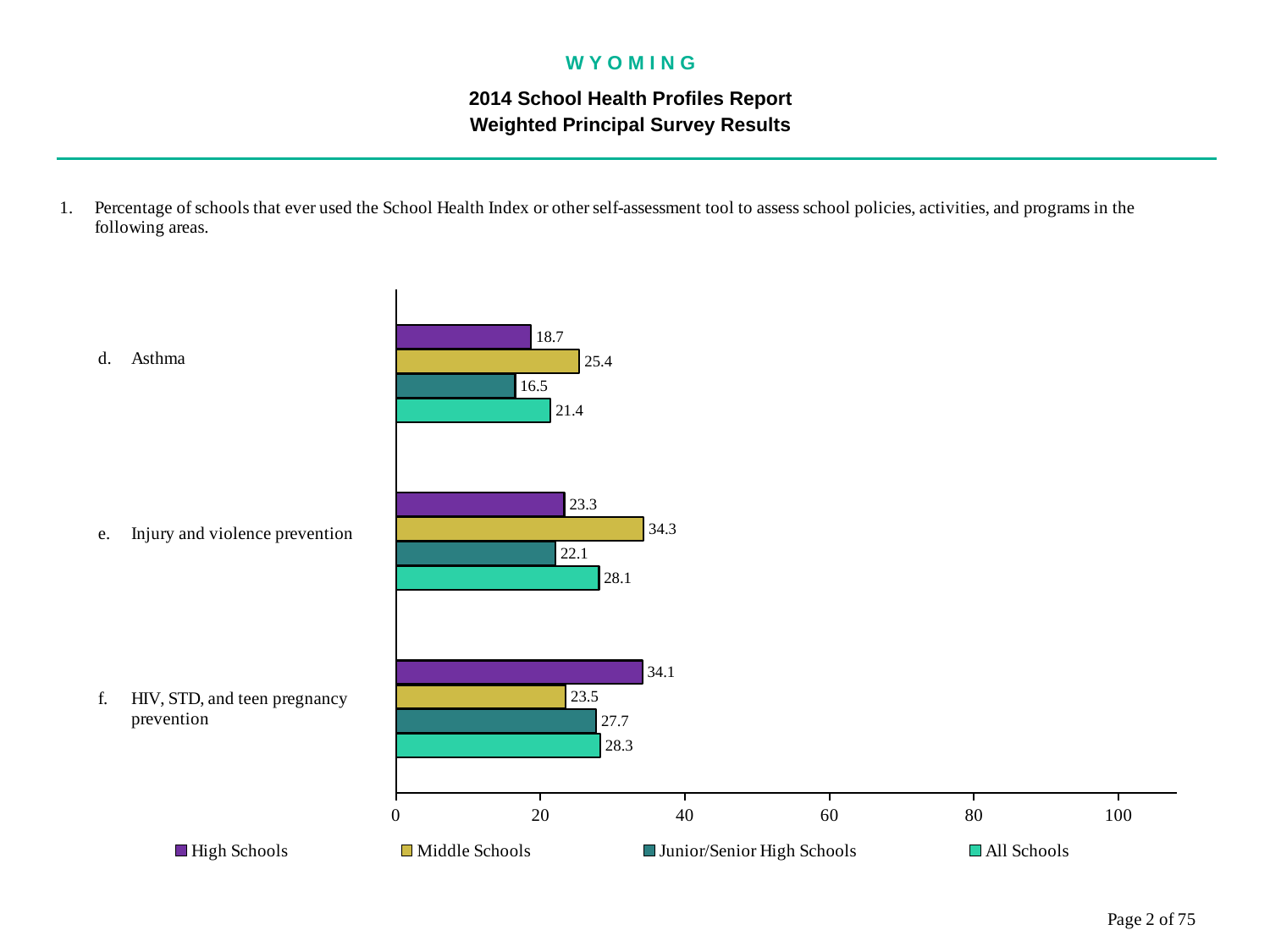
What is the value for Middle Schools in the Injury and violence prevention category? 34.3 Which school type has the highest value in the HIV, STD, and teen pregnancy prevention category? High Schools What is the difference between the Middle Schools and High Schools values in the Injury and violence prevention category? 11.0 What is the value for High Schools in the Asthma category? 18.7 What kind of chart is shown on the slide? bar chart Is the value for Middle Schools in the Asthma category greater or less than 40? less How many categories are shown on the chart? 3 What is the value for All Schools in the Asthma category? 21.4 What is the value for Junior/Senior High Schools in the HIV, STD, and teen pregnancy prevention category? 27.7 How many series does the legend list? 4 Which is larger: the All Schools value for Injury and violence prevention or the All Schools value for HIV, STD, and teen pregnancy prevention? HIV, STD, and teen pregnancy prevention Which school type has the lowest value in the Asthma category? Junior/Senior High Schools